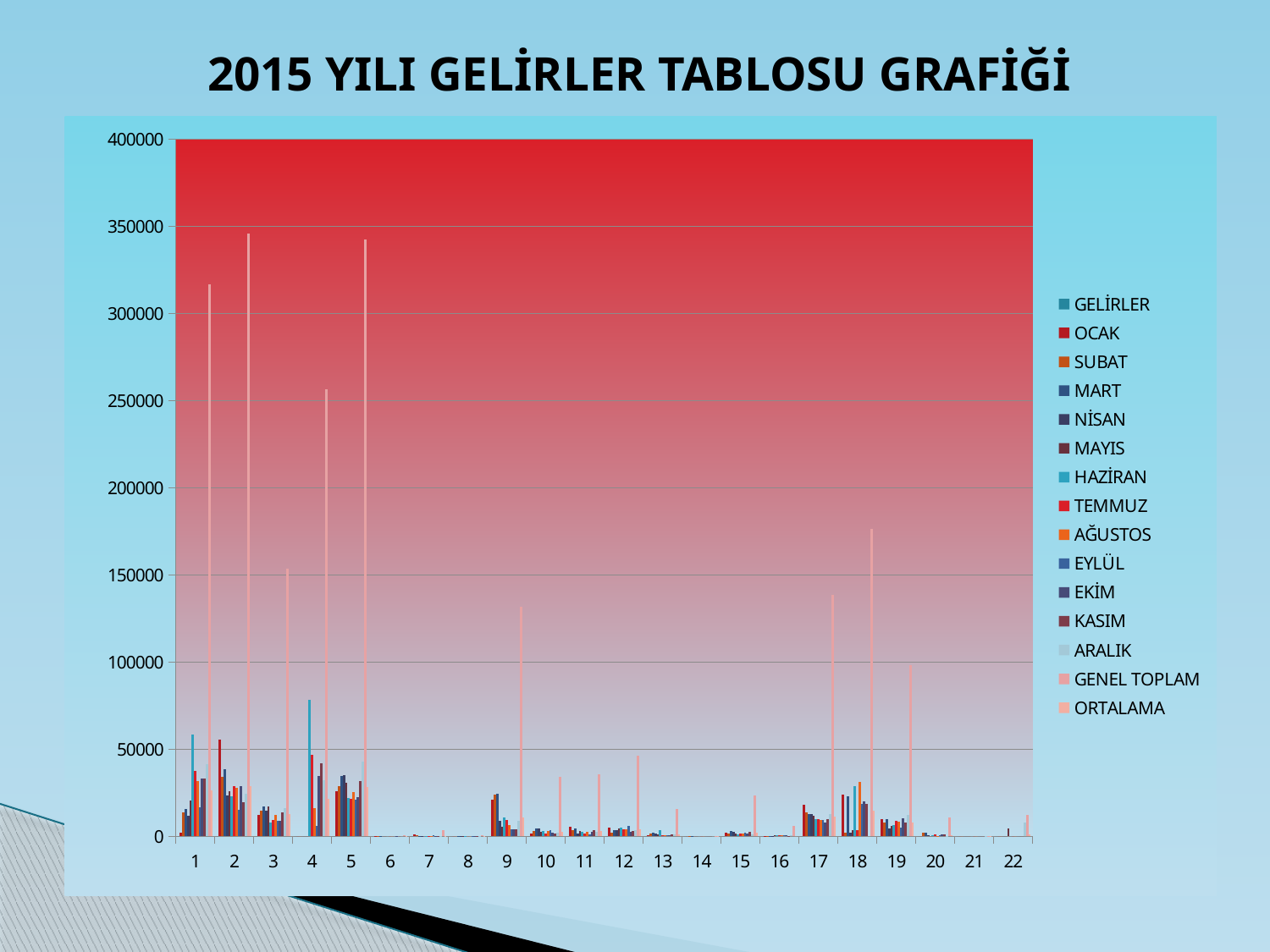
Which series is listed last in the legend? ORTALAMA What kind of chart is shown on the slide? bar chart Is the GENEL TOPLAM value for category 17 greater or less than 150000? less Is the GENEL TOPLAM value for category 9 greater or less than 150000? less Is the GENEL TOPLAM value for category 18 greater or less than 150000? greater How many categories are shown along the x axis? 22 Which has the larger GENEL TOPLAM value, category 4 or category 9? category 4 How many series does the legend list? 15 What is the title of the slide's chart? 2015 YILI GELİRLER TABLOSU GRAFİĞİ